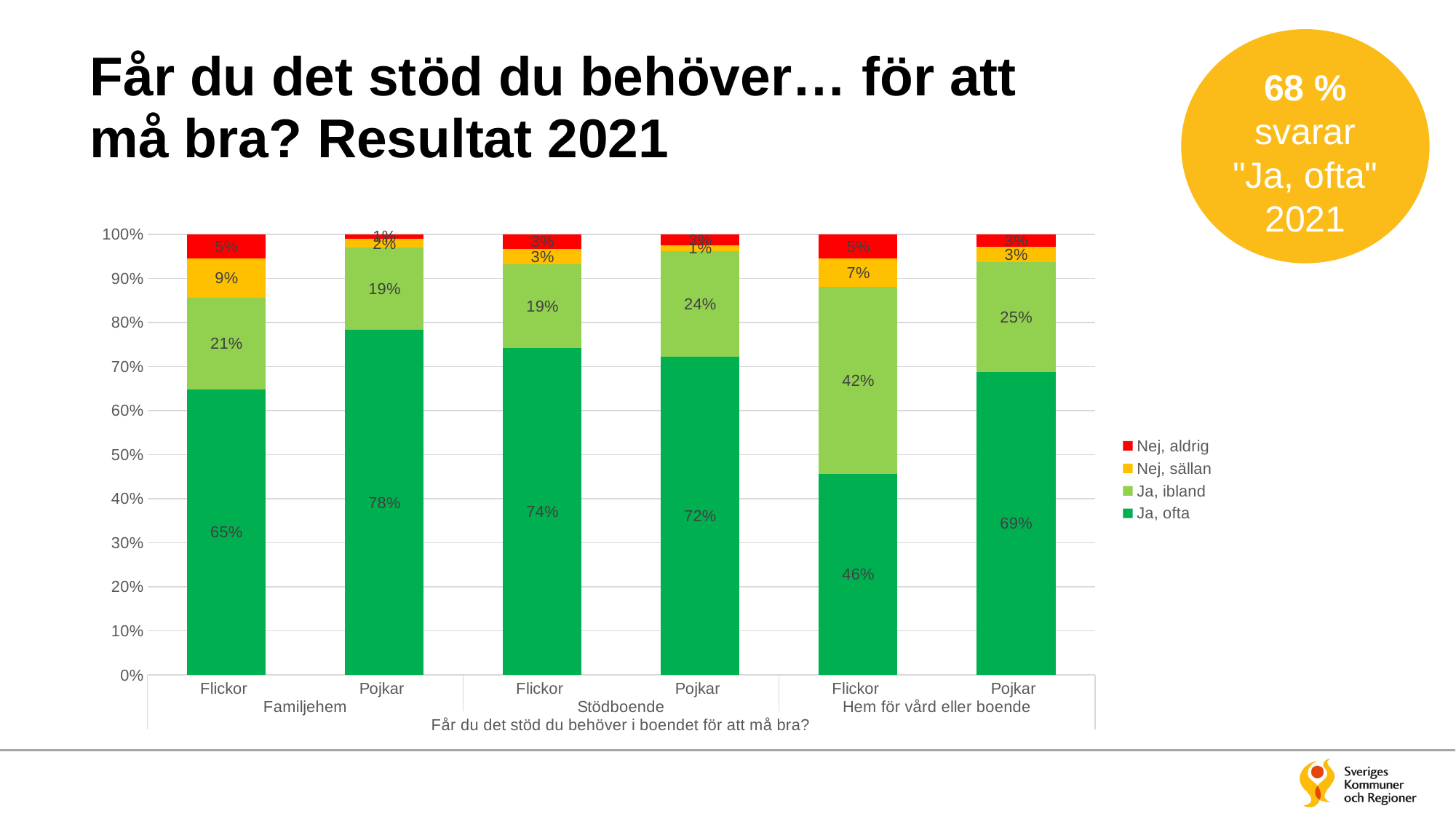
How many series does the legend list? 4 Which is larger, the "Ja, ofta" value for Flickor in Stödboende or for Pojkar in Stödboende? Flickor in Stödboende How many bars are plotted in the chart? 6 What is the difference between the "Ja, ofta" values for Pojkar and Flickor in Hem för vård eller boende? 23% What kind of chart is shown on the slide? stacked bar chart What is the "Nej, aldrig" value for Flickor in Familjehem? 5% Which legend entry is shown in red? Nej, aldrig What is the "Ja, ofta" value for Flickor in Familjehem? 65% What is the "Ja, ibland" value for Flickor in Hem för vård eller boende? 42% What is the "Nej, sällan" value for Pojkar in Stödboende? 1% Which bar has the highest "Ja, ofta" value? Pojkar, Familjehem Which bar has the lowest "Ja, ofta" value? Flickor, Hem för vård eller boende